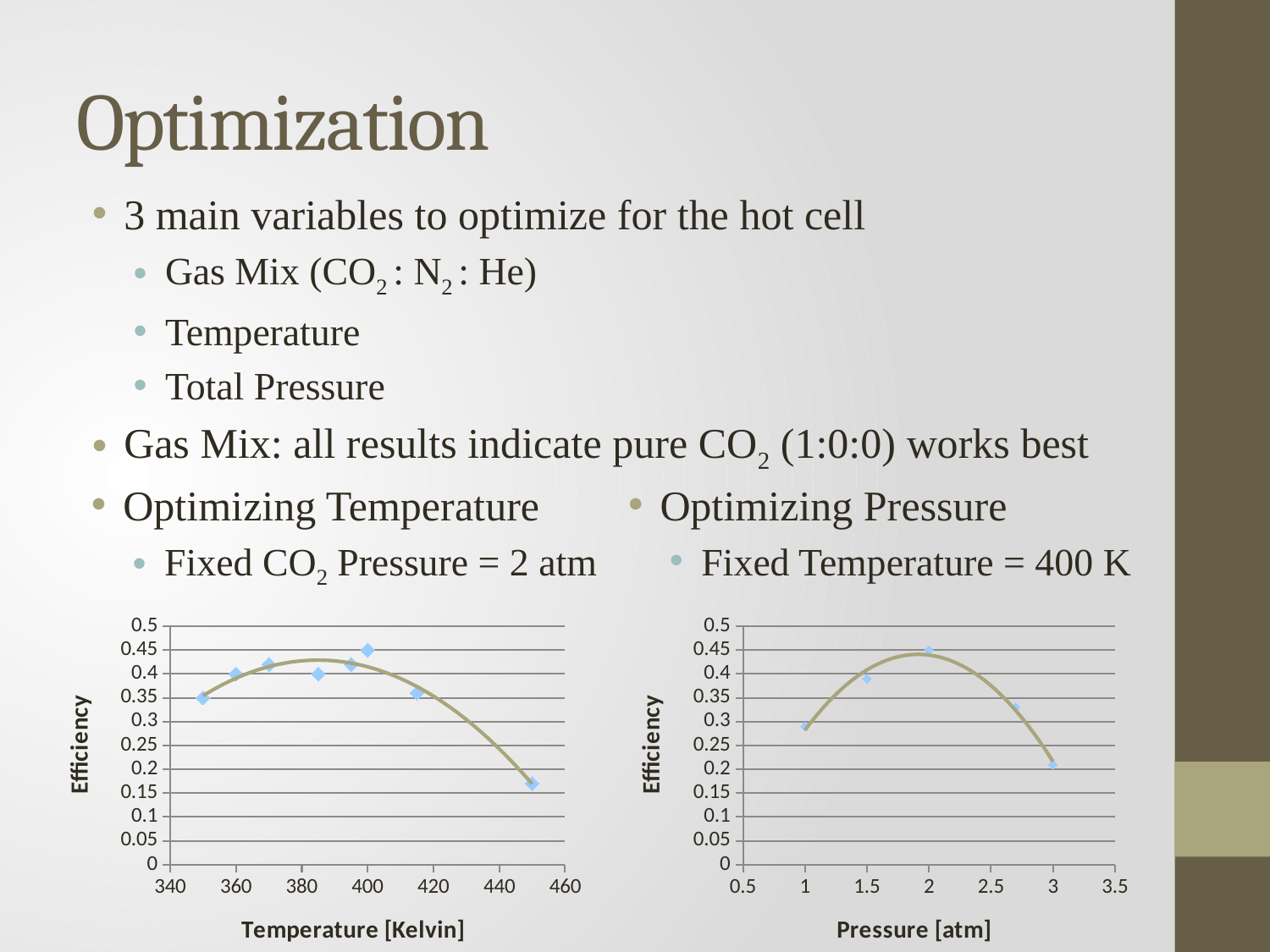
What is the x-axis label of the right chart? Pressure [atm] In the left chart (Temperature [Kelvin]), is the efficiency at 450 K greater or less than 0.2? less How many data points are plotted in the right chart (Pressure [atm])? 5 In the right chart (Pressure [atm]), does efficiency rise or fall as pressure increases from 2 atm to 3 atm? fall In the left chart (Temperature [Kelvin]), at which temperature is the efficiency lowest? 450 K In the right chart (Pressure [atm]), at which pressure is the efficiency highest? 2 atm What is the y-axis label of the left chart? Efficiency In the left chart (Temperature [Kelvin]), is the efficiency at 400 K greater or less than 0.4? greater What kind of chart is the left chart with the x axis labelled Temperature [Kelvin]? scatter chart How many data points are plotted in the left chart (Temperature [Kelvin])? 8 In the right chart (Pressure [atm]), is the efficiency at 2 atm greater or less than 0.4? greater